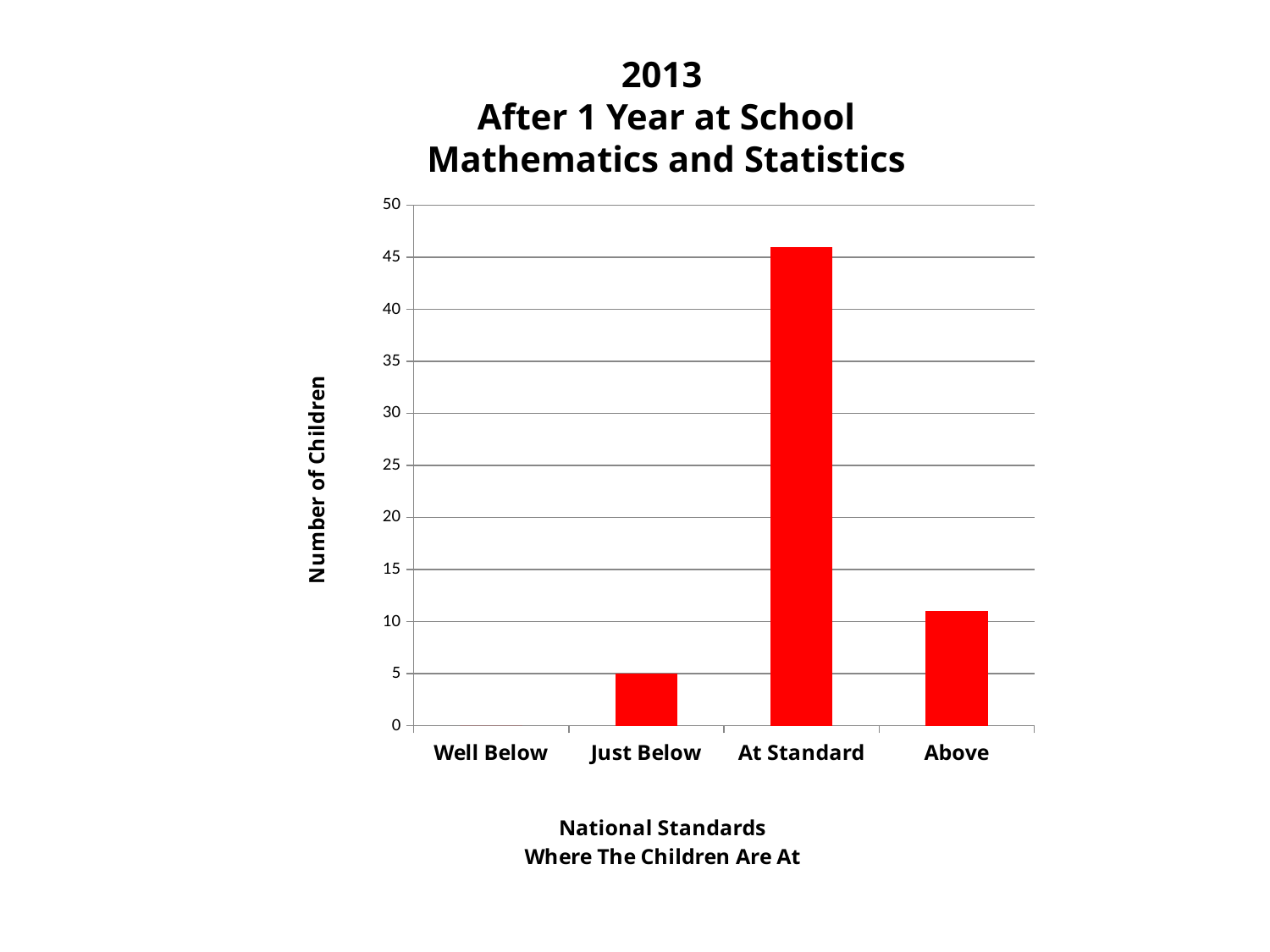
Is the value for Well Below greater or less than 5? less Is the value for At Standard greater or less than 40? greater What is the title of the horizontal axis? National Standards Where The Children Are At Is the value for At Standard greater or less than 50? less What is the number of children for Just Below? 5 Which has more children, Above or Just Below? Above How many categories are shown on the x axis? 4 Which category has the lowest number of children? Well Below What kind of chart is shown on the slide? bar chart Which category has the highest number of children? At Standard What is the title of the vertical axis? Number of Children